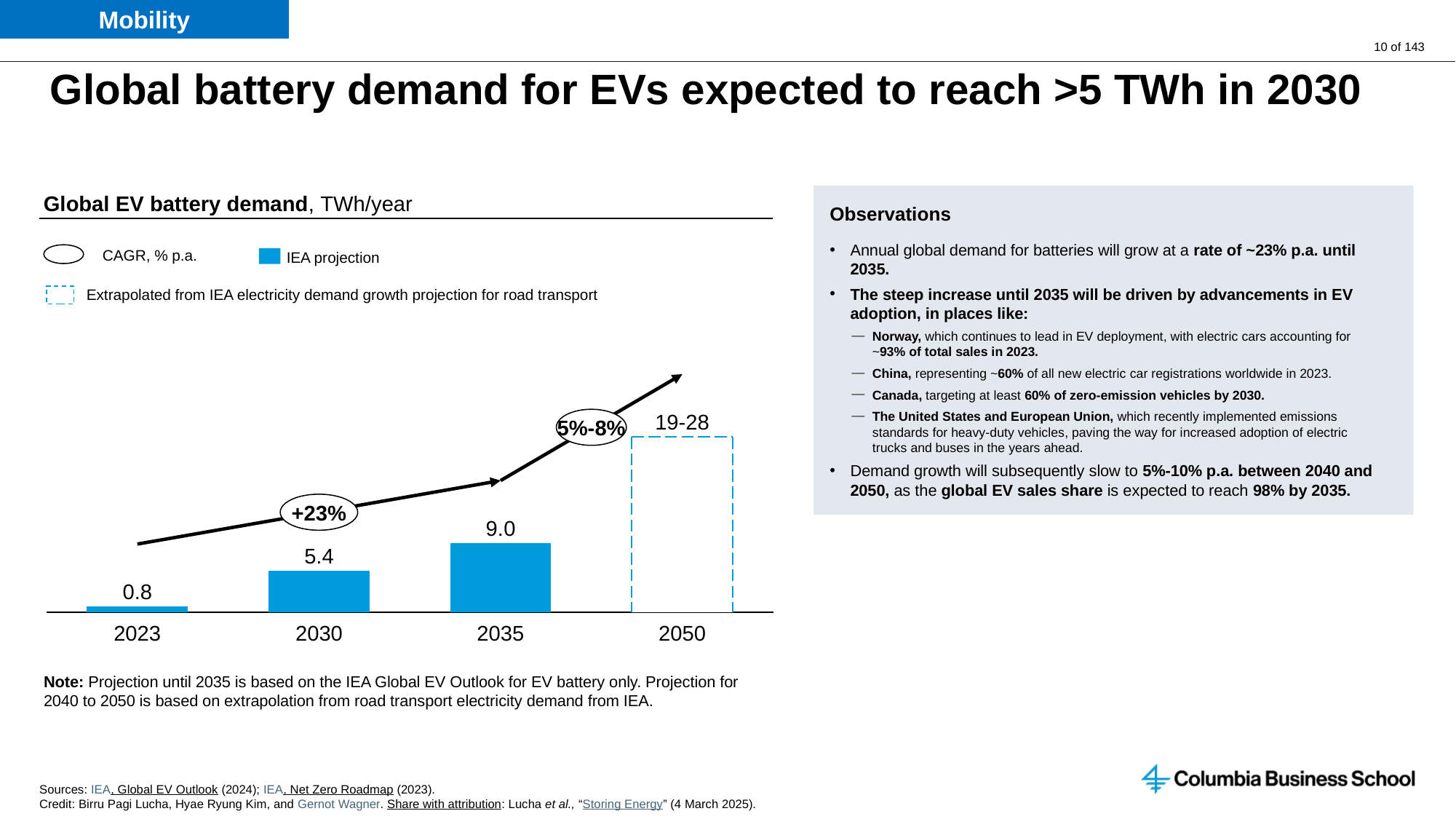
What value range is shown for 2050? 19-28 How many years are shown on the x axis? 4 Which is larger, the value for 2030 or the value for 2023? 2030 What CAGR is shown between 2035 and 2050? 5%-8% What is the global EV battery demand value shown for 2023? 0.8 Which year has the highest global EV battery demand? 2050 Which year has the lowest global EV battery demand? 2023 What is the global EV battery demand value shown for 2035? 9.0 What kind of chart is this? Bar chart What is the difference between the 2035 and 2030 values? 3.6 What is the global EV battery demand value shown for 2030? 5.4 Do the values rise or fall from 2023 to 2050? Rise